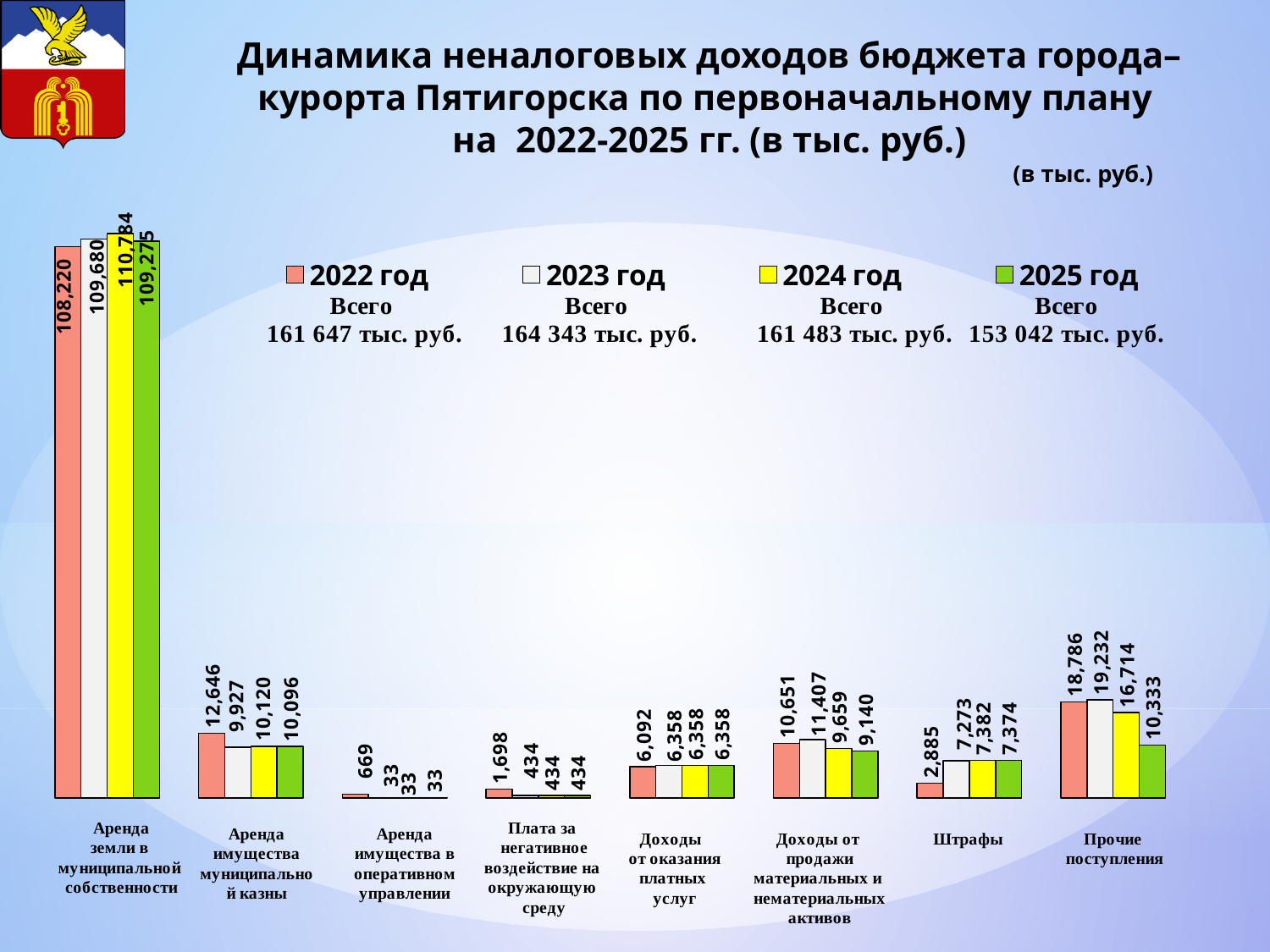
How many series does the legend list? 4 How many categories are shown on the x axis of the chart? 8 According to the legend, what is the total («Всего») for 2023 год? 164 343 тыс. руб. Which category has the highest value for 2024 год? Аренда земли в муниципальной собственности Do the values for «Прочие поступления» rise or fall from 2023 год to 2025 год? fall Which is larger for «Доходы от продажи материальных и нематериальных активов»: the 2023 год value or the 2025 год value? 2023 год What is the value for 2022 год in the category «Аренда земли в муниципальной собственности»? 108,220 What kind of chart is shown on the slide? bar chart What is the difference between the 2022 год and 2023 год values for «Штрафы»? 4,388 What is the value for 2025 год in the category «Прочие поступления»? 10,333 Which category has the lowest value for 2023 год? Аренда имущества в оперативном управлении What is the value for 2023 год in the category «Штрафы»? 7,273